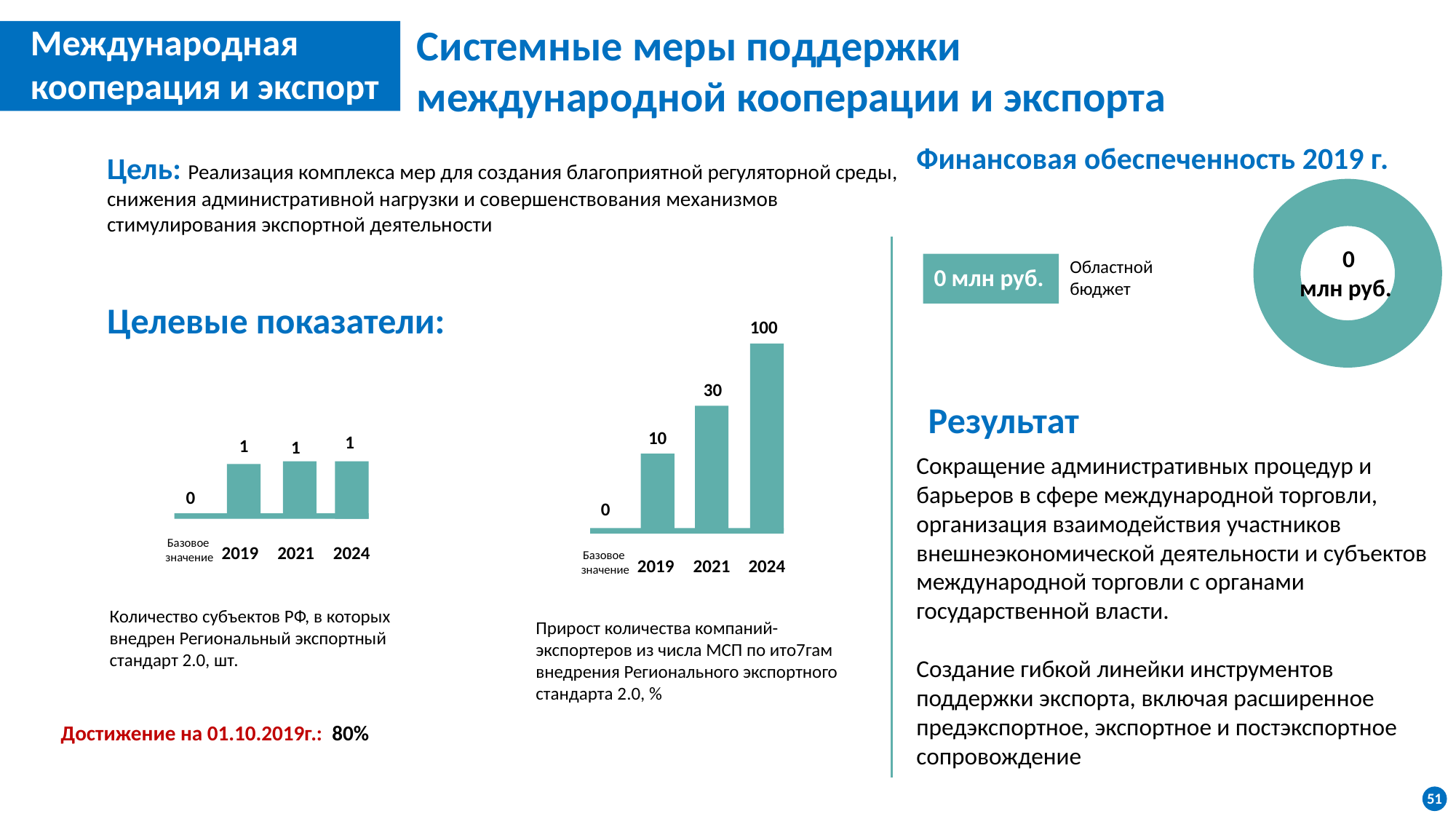
How many categories are shown in the left bar chart (Количество субъектов РФ)? 4 In the left bar chart (Количество субъектов РФ), what is the value for Базовое значение? 0 In the middle bar chart (Прирост количества компаний-экспортеров), which category has the lowest value? Базовое значение In the left bar chart (Количество субъектов РФ), what is the value for 2024? 1 Do the values in the middle bar chart (Прирост количества компаний-экспортеров) rise or fall from left to right? rise What type of chart is used under the heading Финансовая обеспеченность 2019 г.? donut chart In the middle bar chart (Прирост количества компаний-экспортеров), what is the difference between the values for 2024 and 2021? 70 In the middle bar chart (Прирост количества компаний-экспортеров), which category has the highest value? 2024 In the middle bar chart (Прирост количества компаний-экспортеров), what is the value for 2019? 10 In the middle bar chart (Прирост количества компаний-экспортеров), which is larger, the value for 2019 or the value for 2021? 2021 In the middle bar chart (Прирост количества компаний-экспортеров), what is the value for 2024? 100 In the middle bar chart (Прирост количества компаний-экспортеров), what is the value for 2021? 30